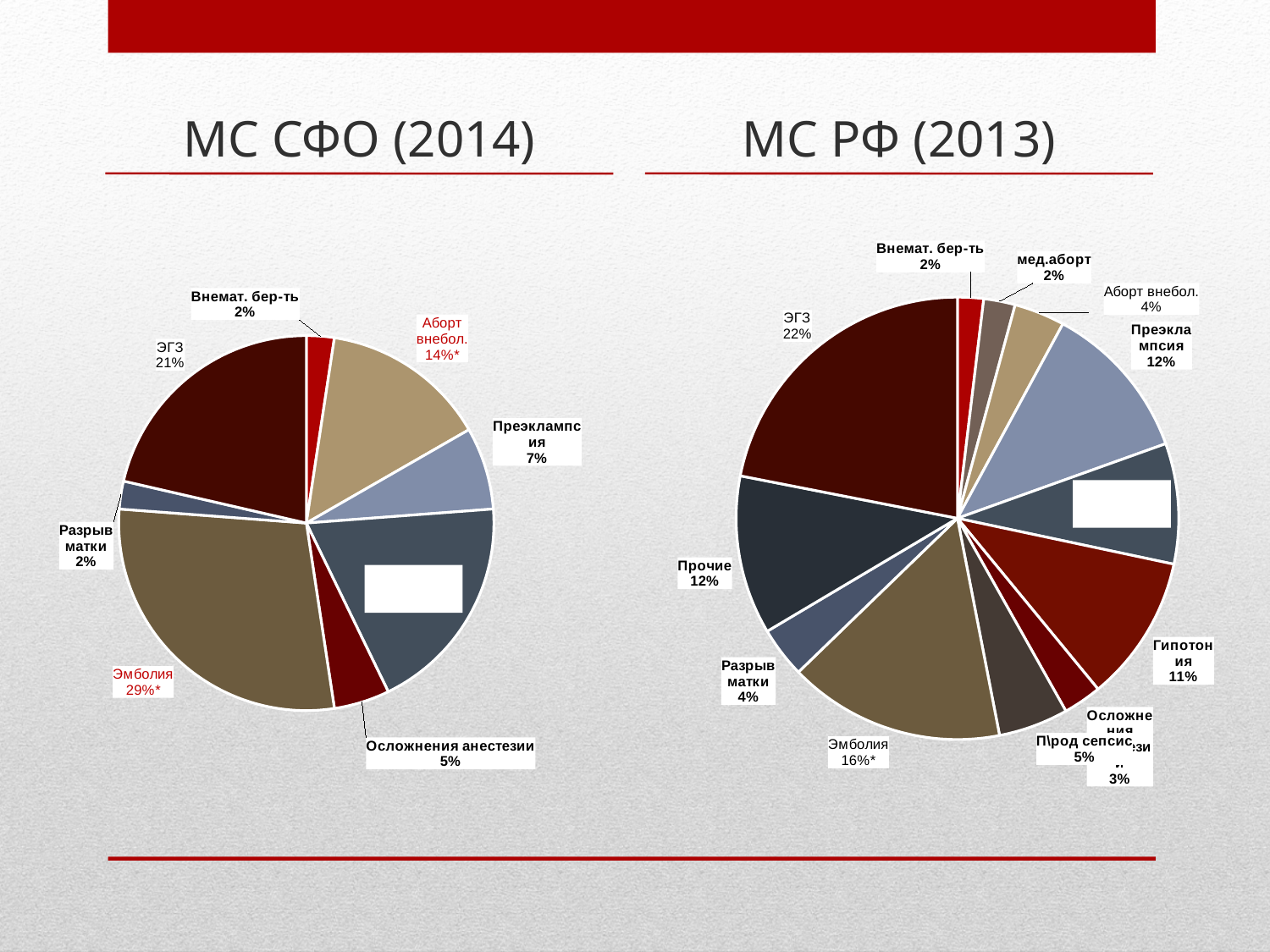
In the МС РФ (2013) chart, what share does ЭГЗ have? 22% In the МС РФ (2013) chart, what is the difference between the shares of Эмболия and П\род сепсис? 11% In the МС СФО (2014) chart, what share does Эмболия have? 29%* In the МС СФО (2014) chart, what is the difference between the shares of Аборт внебол. and Преэклампсия? 7% In the МС РФ (2013) chart, what is the share for Прочие? 12% In the МС СФО (2014) chart, what share does ЭГЗ have? 21% In the МС СФО (2014) chart, which labelled category has the largest share? Эмболия In the МС РФ (2013) chart, which is larger: Преэклампсия or Разрыв матки? Преэклампсия In the МС СФО (2014) chart, what is the share for Преэклампсия? 7% Which chart shows a larger share for Эмболия: МС СФО (2014) or МС РФ (2013)? МС СФО (2014) In the МС РФ (2013) chart, what share does Гипотония have? 11% What kind of chart is shown under the title МС СФО (2014)? pie chart